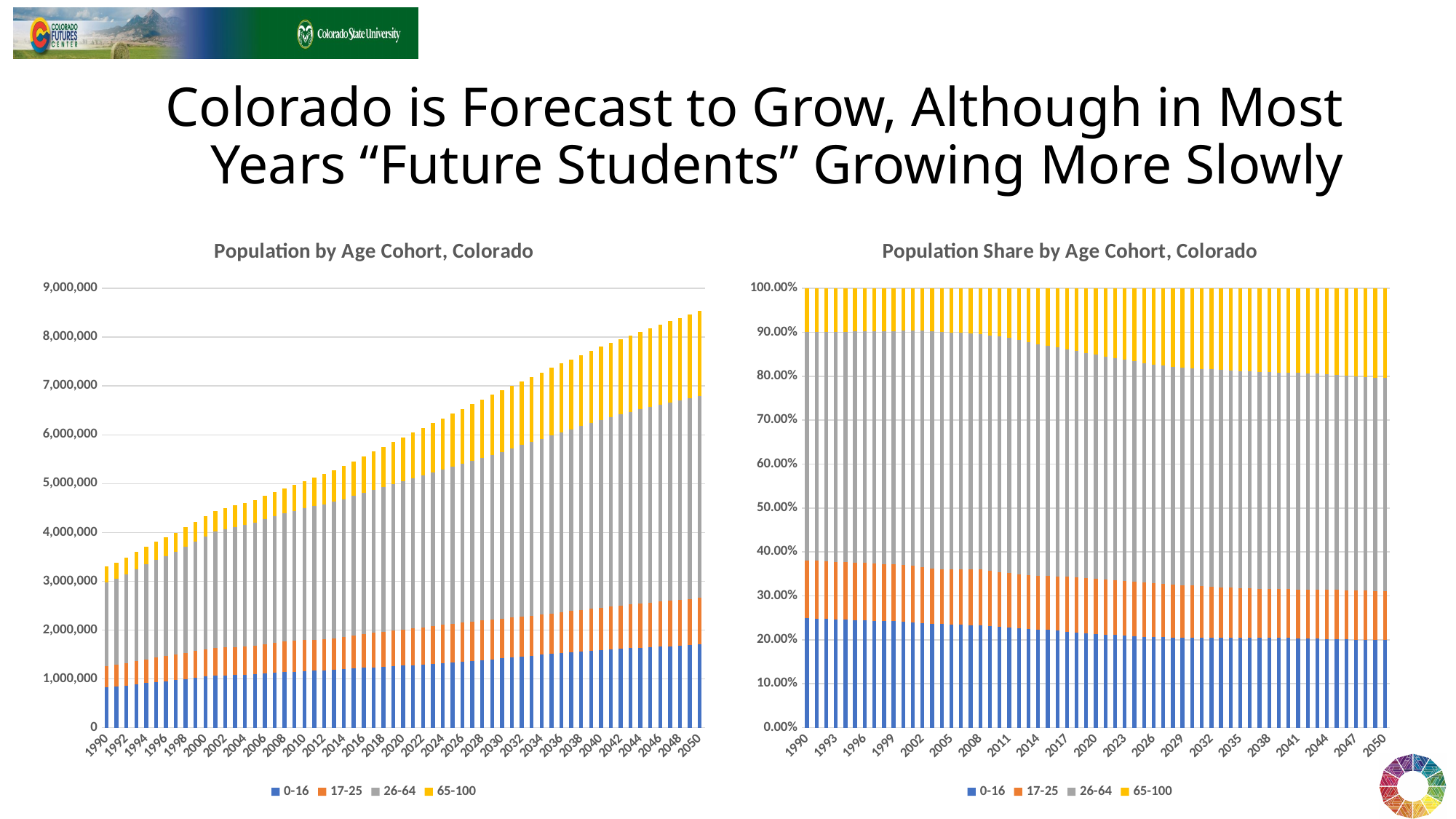
In the left chart, "Population by Age Cohort, Colorado", is the total population for 2050 greater or less than 8,000,000? greater How many series does the legend of the left chart, "Population by Age Cohort, Colorado", list? 4 In the left chart, "Population by Age Cohort, Colorado", which age cohorts are listed in the legend? 0-16, 17-25, 26-64, 65-100 What is the title of the right chart? Population Share by Age Cohort, Colorado What kind of chart is the left chart, "Population by Age Cohort, Colorado"? Stacked bar chart In the right chart, "Population Share by Age Cohort, Colorado", does the share of the 65-100 cohort rise or fall from 1990 to 2050? Rise In the left chart, "Population by Age Cohort, Colorado", does the total population rise or fall from 1990 to 2050? Rise In the right chart, "Population Share by Age Cohort, Colorado", is the share of the 0-16 cohort larger in 1990 or in 2050? 1990 How many series does the legend of the right chart, "Population Share by Age Cohort, Colorado", list? 4 In the left chart, "Population by Age Cohort, Colorado", is the total population for 1990 greater or less than 4,000,000? less In the left chart, "Population by Age Cohort, Colorado", which year has the highest total population, 1990 or 2050? 2050 In the right chart, "Population Share by Age Cohort, Colorado", is the share of the 0-16 cohort in 1990 greater or less than 20.00%? greater